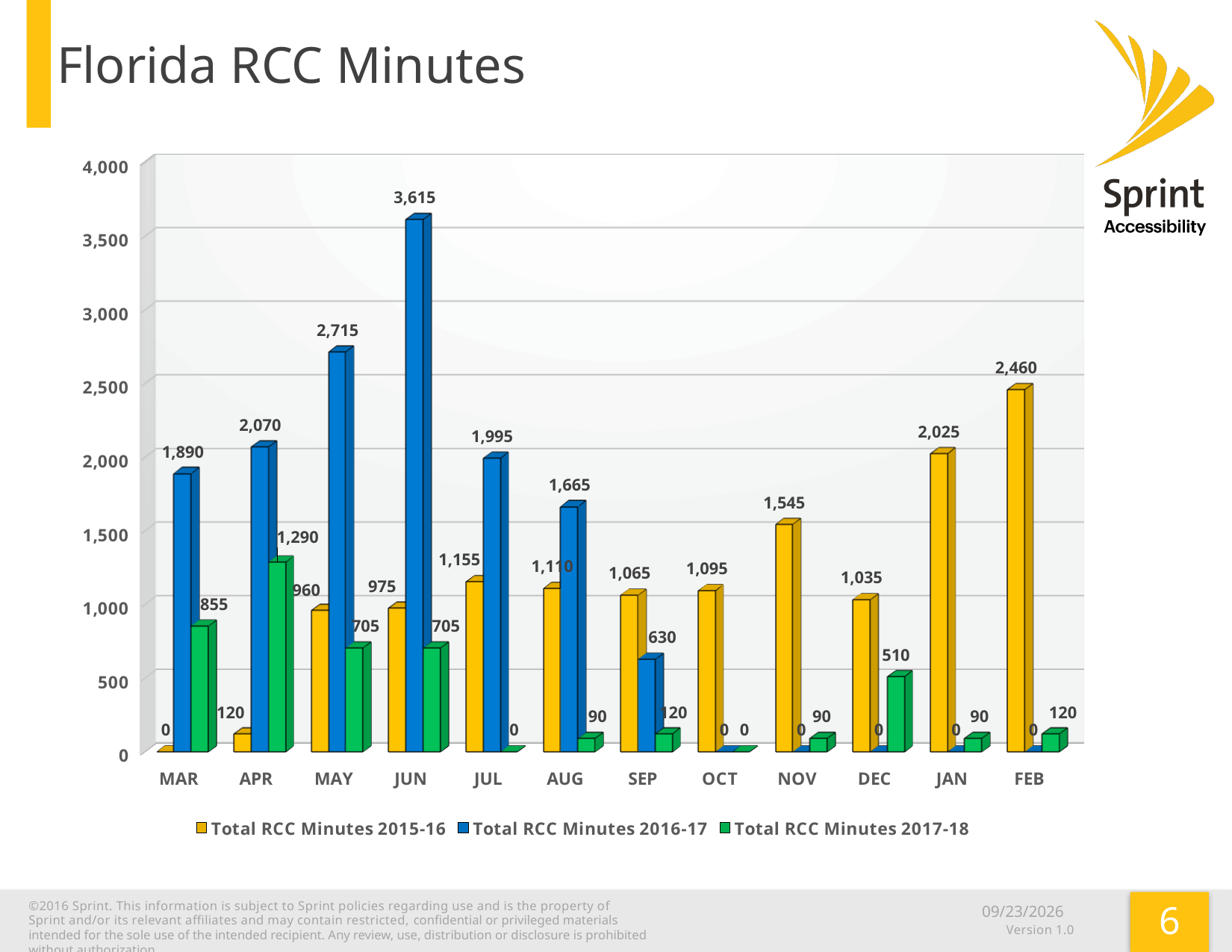
Which month has the highest value for Total RCC Minutes 2017-18? APR What is the value of Total RCC Minutes 2016-17 for JUN? 3,615 How many series does the legend list? 3 Is the value of Total RCC Minutes 2015-16 for JAN greater or less than 2,000? greater What is the value of Total RCC Minutes 2015-16 for NOV? 1,545 Which is larger in SEP: Total RCC Minutes 2015-16 or Total RCC Minutes 2016-17? Total RCC Minutes 2015-16 What is the title of the chart? Florida RCC Minutes Which month has the highest value for Total RCC Minutes 2015-16? FEB How many months are shown on the x axis? 12 What is the value of Total RCC Minutes 2017-18 for APR? 1,290 What is the difference between Total RCC Minutes 2016-17 for JUN and for MAY? 900 What type of chart is shown on the slide? bar chart